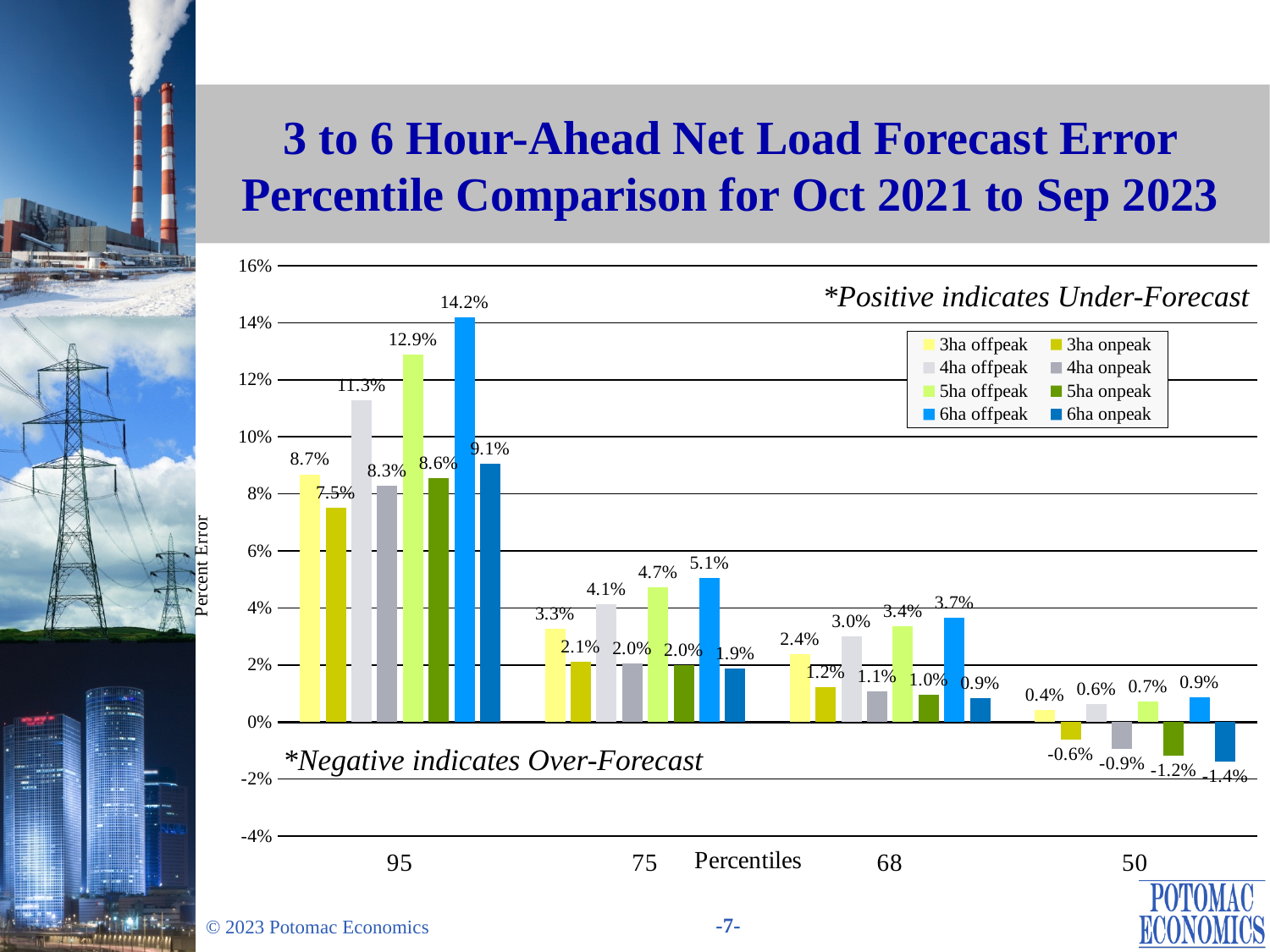
How many percentile categories are shown on the x axis? 4 How many series does the legend list? 8 Which series has the lowest value at the 50 percentile? 6ha onpeak What is the value for 3ha onpeak at the 95 percentile? 7.5% What is the value for 6ha offpeak at the 95 percentile? 14.2% Which series has the highest value at the 95 percentile? 6ha offpeak What kind of chart is shown on the slide? Bar chart What is the value for 4ha onpeak at the 50 percentile? -0.9% Do the 6ha offpeak values rise or fall moving from the 95 percentile to the 50 percentile? Fall What is the title of the vertical axis? Percent Error What is the difference between the 6ha offpeak and 3ha offpeak values at the 95 percentile? 5.5 percentage points At the 75 percentile, which is larger: 5ha offpeak or 4ha offpeak? 5ha offpeak